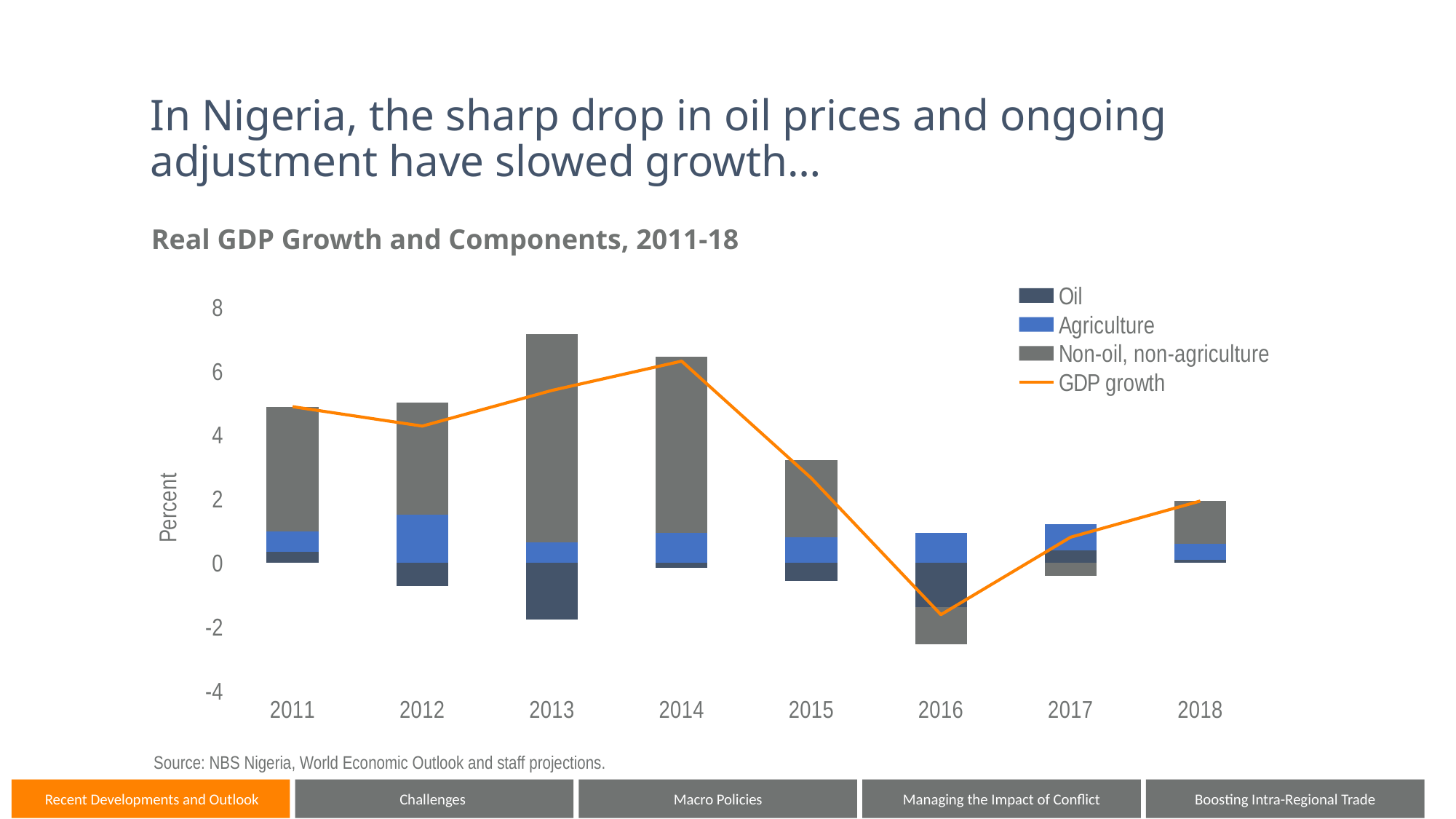
Is the GDP growth value for 2016 greater or less than 0? less Which year has the higher GDP growth, 2013 or 2018? 2013 In which year is the GDP growth line at its lowest? 2016 Is the GDP growth value for 2018 greater or less than 4? less In which year is the GDP growth line at its highest? 2014 What is the title of the chart? Real GDP Growth and Components, 2011-18 Is the GDP growth value for 2013 greater or less than 4? greater What is the label on the vertical axis? Percent What kind of chart is shown on the slide? A stacked bar chart with a line overlay How many series does the legend list? 4 How many years are shown on the x axis? 8 Does the GDP growth line rise or fall from 2014 to 2016? It falls